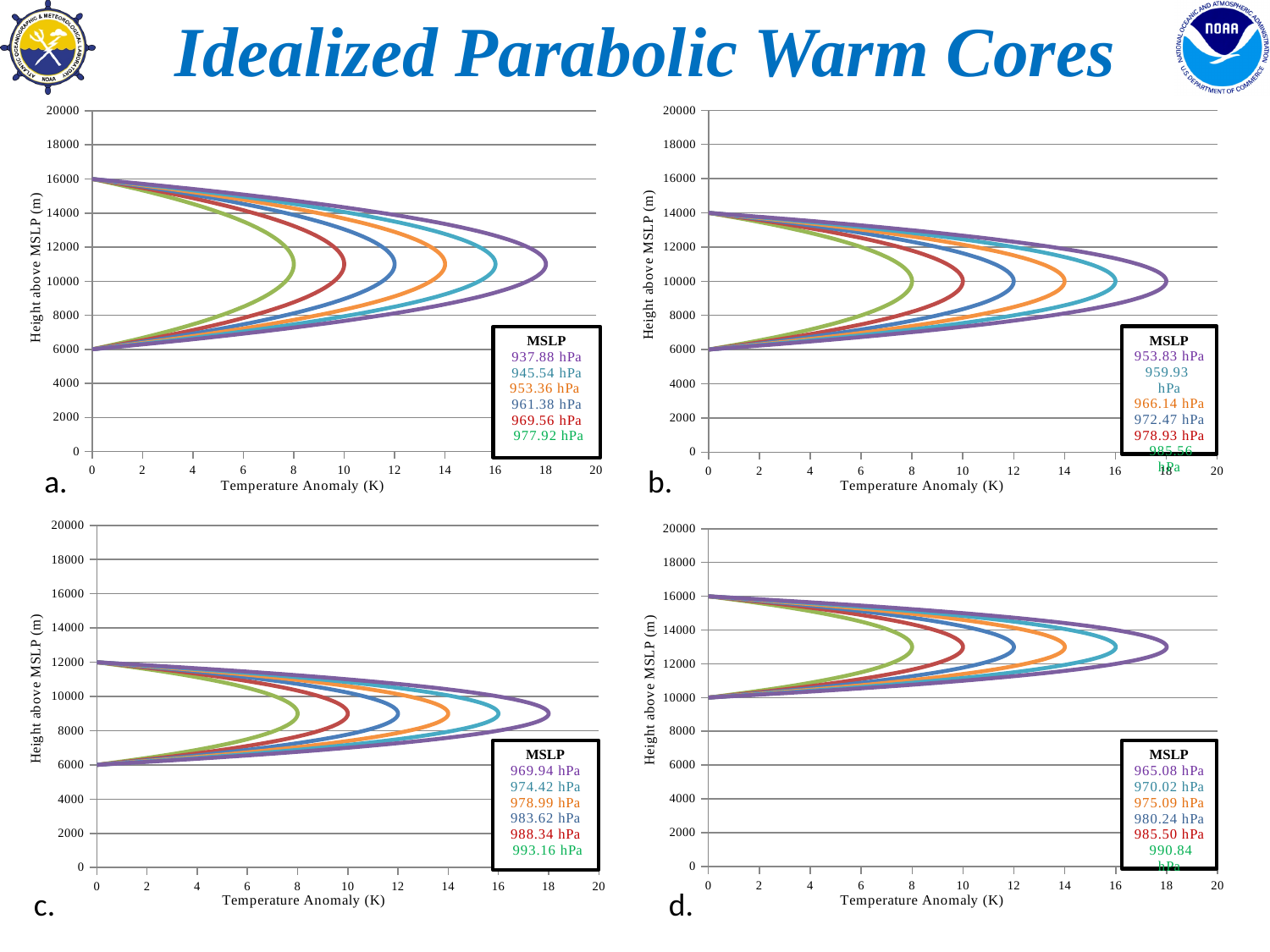
In chart b. (top right), what MSLP value is listed for the red curve? 978.93 hPa In chart a. (top left), what is the maximum temperature anomaly reached by the purple curve? 18 K In chart c. (bottom left), which curve has the lowest MSLP value in the legend? purple (969.94 hPa) In chart a. (top left), what MSLP value is listed for the green curve? 977.92 hPa In chart d. (bottom right), what is the difference between the MSLP values of the purple and green curves? 25.76 hPa What is the x-axis label of chart d. (bottom right)? Temperature Anomaly (K) In chart b. (top right), at what height above MSLP do the curves reach their maximum temperature anomaly? 10000 m How many curves are plotted in chart a. (top left)? 6 In chart c. (bottom left), what MSLP value is listed for the green curve? 993.16 hPa In chart a. (top left), what MSLP value is listed for the purple curve? 937.88 hPa In chart d. (bottom right), is the MSLP of the blue curve (980.24 hPa) greater or less than the MSLP of the orange curve (975.09 hPa)? greater What kind of chart is chart a. (top left)? line chart